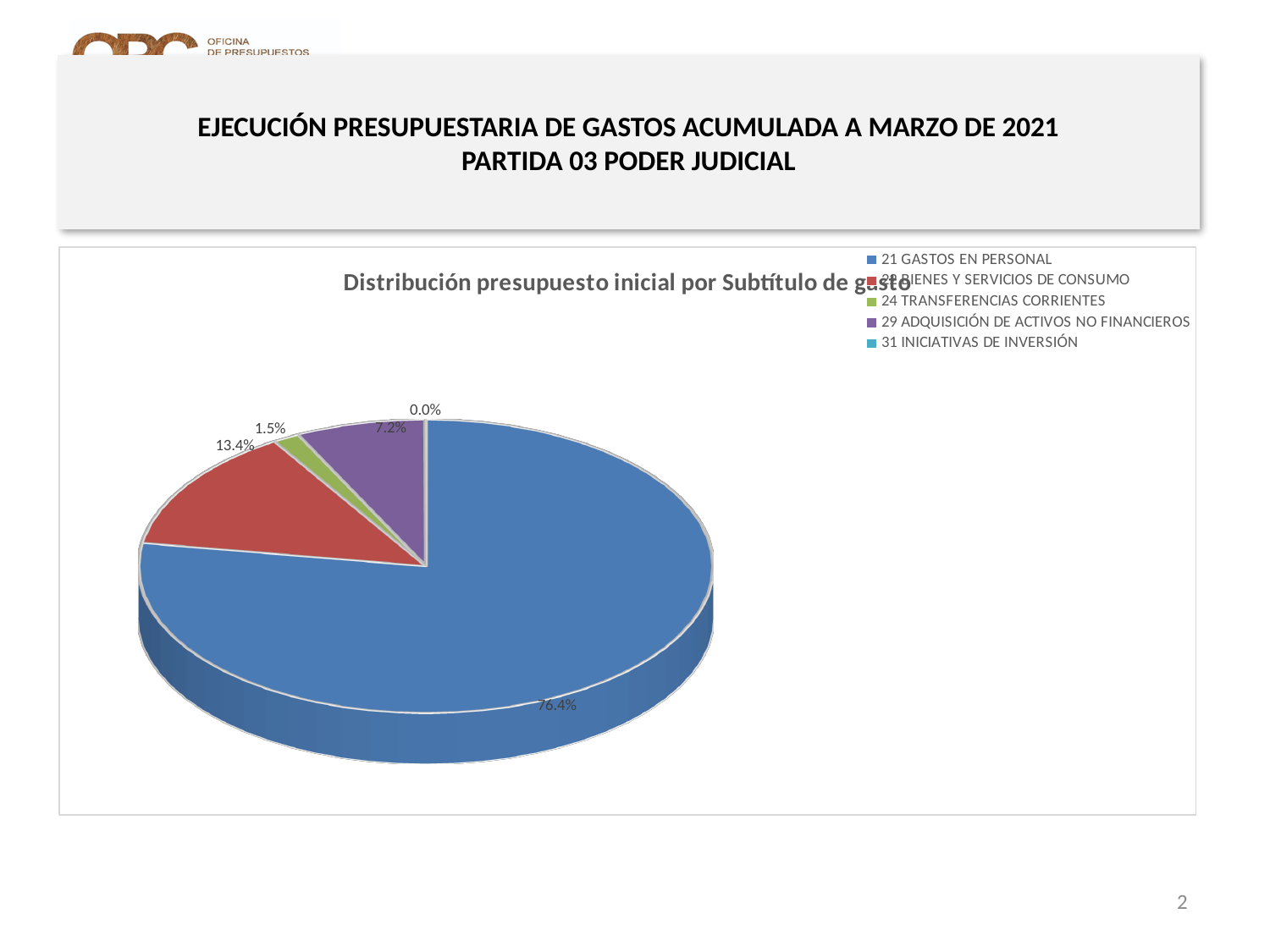
What share of the pie does 21 GASTOS EN PERSONAL represent? 76.4% What kind of chart is shown on the slide? Pie chart Which category has the largest slice of the pie? 21 GASTOS EN PERSONAL What percentage is shown for 31 INICIATIVAS DE INVERSIÓN? 0.0% What percentage is shown for 29 ADQUISICIÓN DE ACTIVOS NO FINANCIEROS? 7.2% What is the difference in percentage points between 21 GASTOS EN PERSONAL and the BIENES Y SERVICIOS DE CONSUMO slice? 63.0 percentage points How many categories does the legend list? 5 What percentage is shown for the BIENES Y SERVICIOS DE CONSUMO slice? 13.4% Which is larger: 29 ADQUISICIÓN DE ACTIVOS NO FINANCIEROS or 24 TRANSFERENCIAS CORRIENTES? 29 ADQUISICIÓN DE ACTIVOS NO FINANCIEROS What is the title of the chart? Distribución presupuesto inicial por Subtítulo de gasto What percentage is shown for 24 TRANSFERENCIAS CORRIENTES? 1.5% Which category has the smallest slice of the pie? 31 INICIATIVAS DE INVERSIÓN